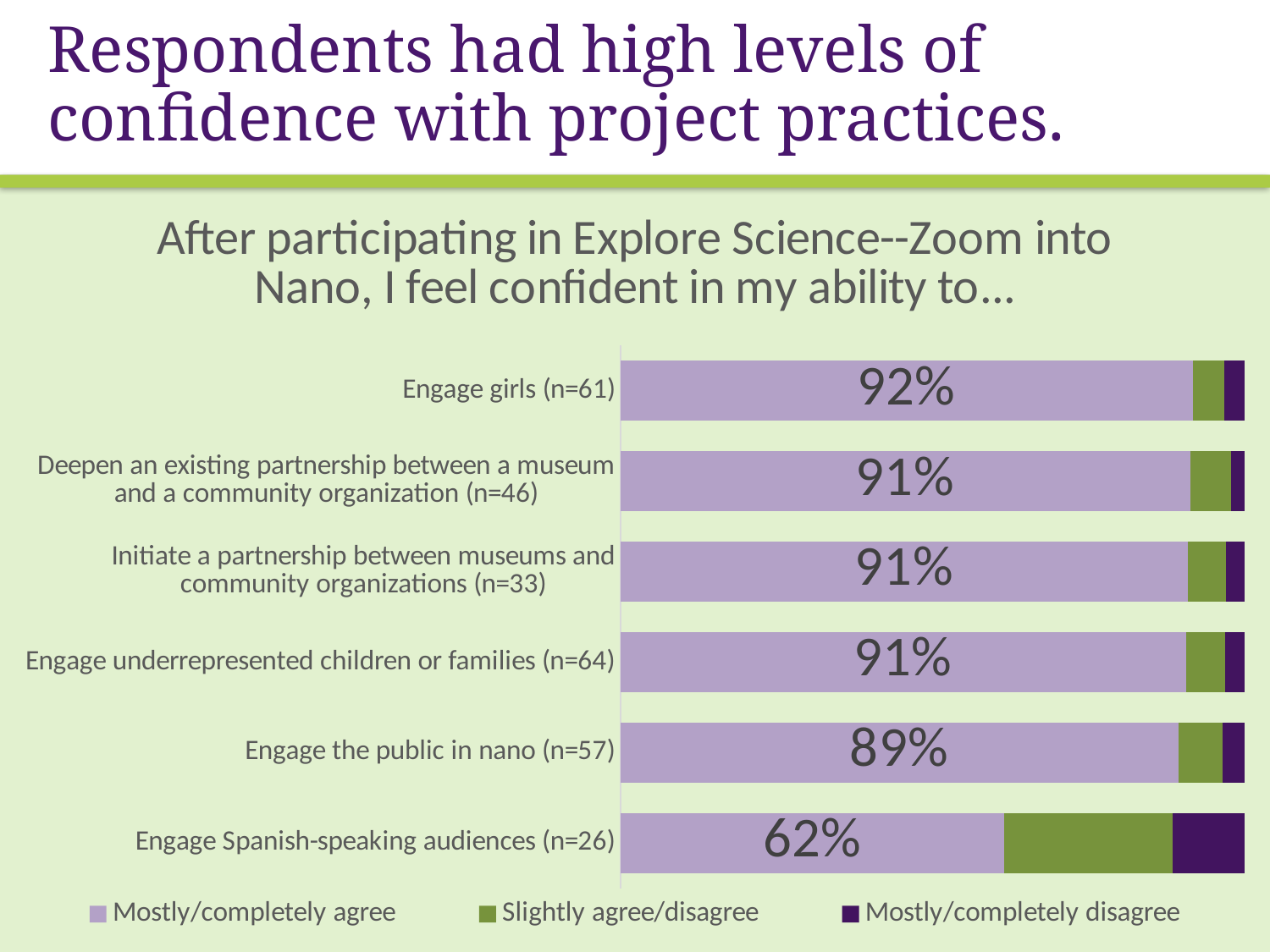
Which category has the lowest Mostly/completely agree percentage? Engage Spanish-speaking audiences (n=26) What is the difference between the Mostly/completely agree percentages for 'Engage the public in nano' and 'Engage Spanish-speaking audiences'? 27% Which legend entry is shown in dark purple? Mostly/completely disagree Which has a larger Mostly/completely agree percentage: 'Engage girls' or 'Engage the public in nano'? Engage girls What is the difference between the Mostly/completely agree percentages for 'Engage girls' and 'Engage Spanish-speaking audiences'? 30% What percentage of respondents mostly/completely agree that they feel confident in their ability to engage girls? 92% What is the Mostly/completely agree value for 'Engage Spanish-speaking audiences (n=26)'? 62% What is the Mostly/completely agree value for 'Engage the public in nano (n=57)'? 89% How many categories are shown in the chart? 6 Which category has the highest Mostly/completely agree percentage? Engage girls (n=61) How many series does the legend list? 3 What kind of chart is shown on the slide? Stacked bar chart